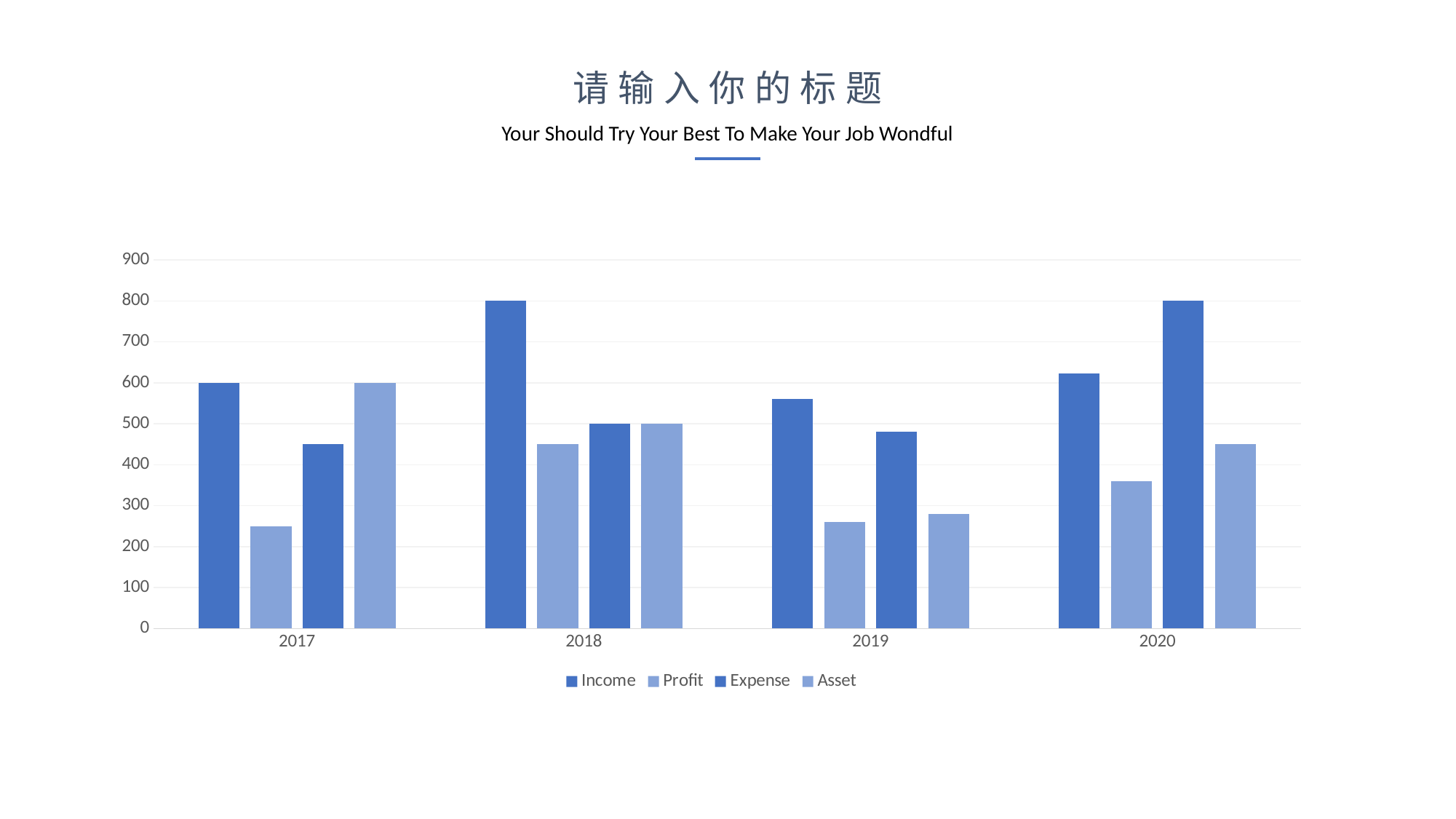
How many series does the legend list? 4 What is the Asset value for 2018? 500 Which year has the lowest Asset value? 2019 Is the Asset value for 2019 greater or less than 300? less What is the Income value for 2018? 800 Which year has the highest Profit value? 2018 How many years are shown on the x axis? 4 What type of chart is shown on the slide? bar chart What is the Expense value for 2020? 800 Is the Profit value for 2017 greater or less than 300? less Which is larger in 2020, Income or Expense? Expense What is the Income value for 2017? 600